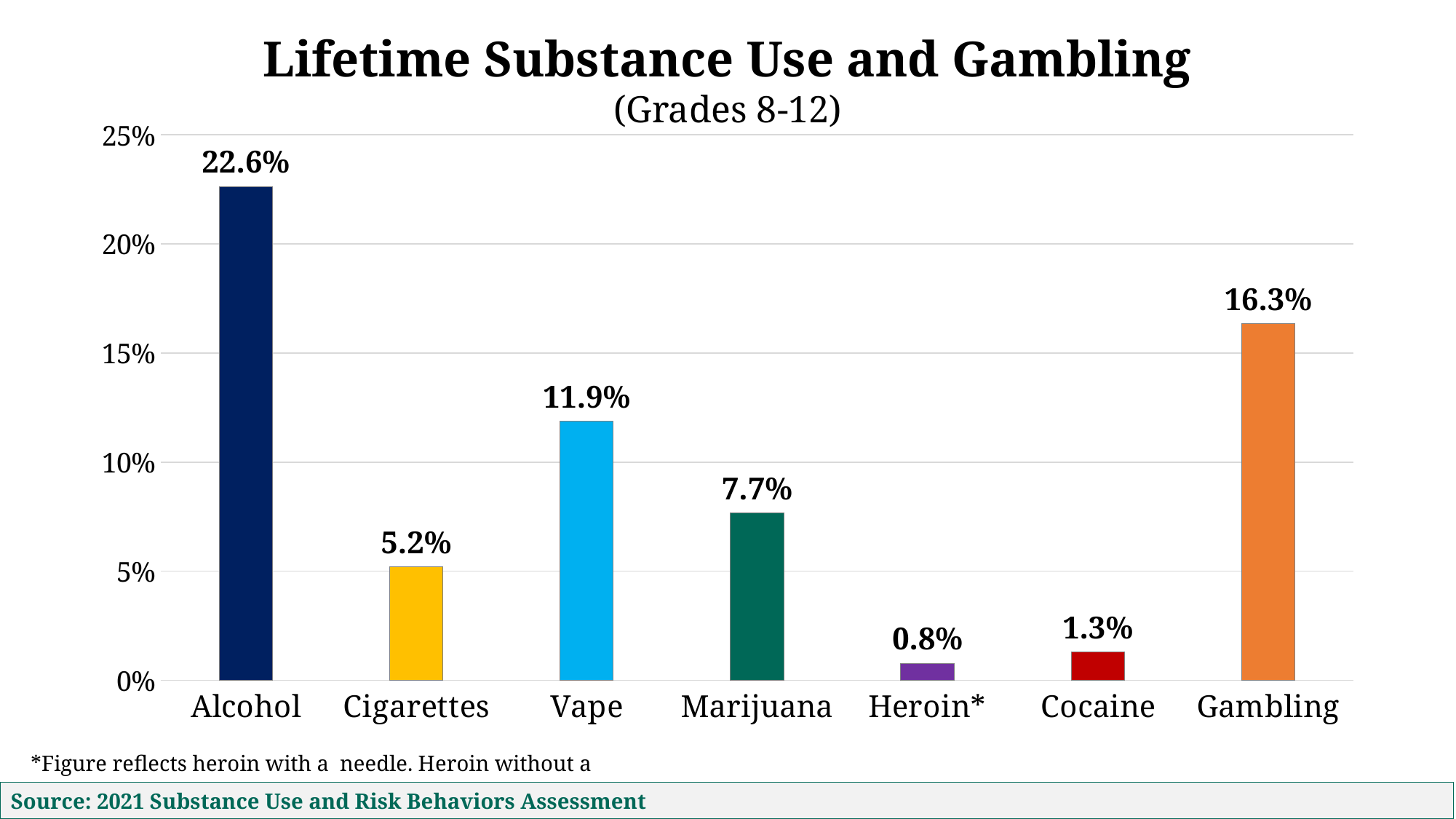
What is the difference between the values for Alcohol and Gambling? 6.3% How many categories are shown on the x axis? 7 Is the value for Vape greater or less than 10%? greater Which category has the highest value? Alcohol What is the difference between the values for Vape and Cigarettes? 6.7% What is the value for Heroin*? 0.8% Which is larger, the value for Marijuana or the value for Cigarettes? Marijuana Which category has the lowest value? Heroin* What is the value for Gambling? 16.3% What is the value for Alcohol? 22.6% What is the title of the chart? Lifetime Substance Use and Gambling (Grades 8-12) What kind of chart is shown on the slide? bar chart